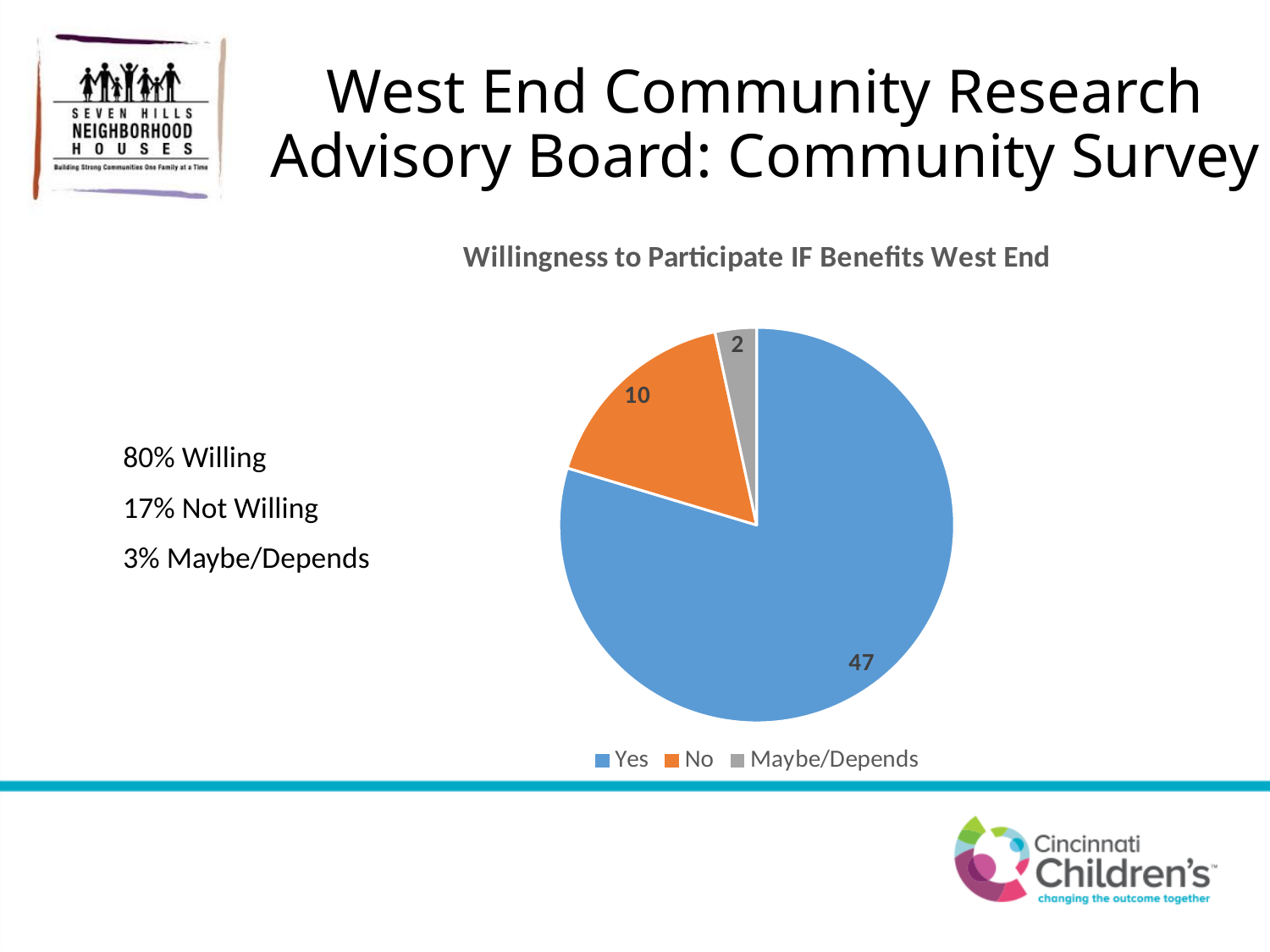
Which category has the smallest slice? Maybe/Depends Which is larger, the No slice or the Maybe/Depends slice? No What is the value for the Yes slice? 47 Which category has the largest slice? Yes What is the value for the Maybe/Depends slice? 2 What is the value for the No slice? 10 What is the title of the chart? Willingness to Participate IF Benefits West End What is the difference between the Yes and No values? 37 How many categories does the legend list? 3 What colour is the Yes slice? blue What kind of chart is shown on the slide? pie chart What is the total of all slices in the pie? 59